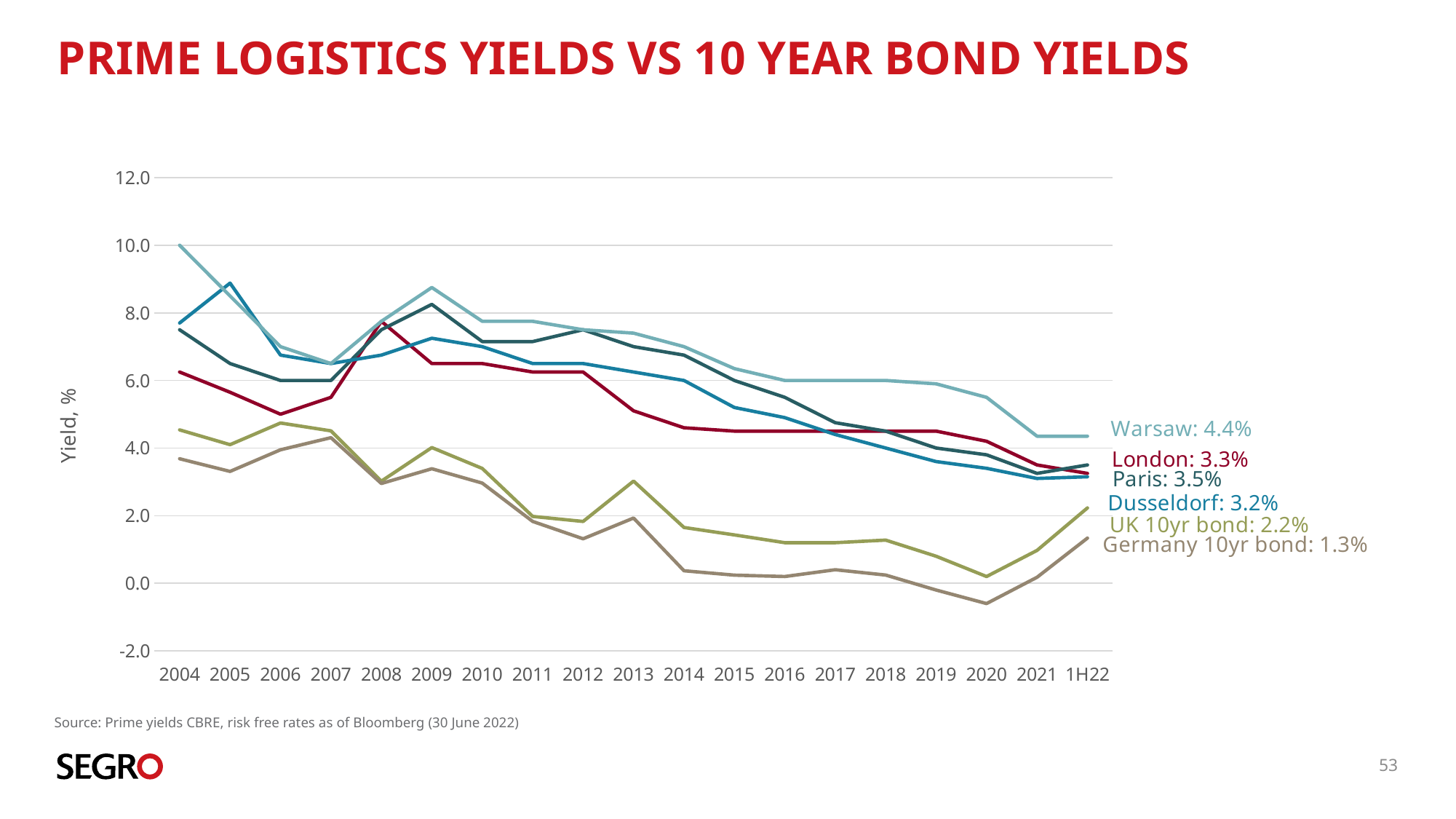
Which series has the highest yield at 1H22? Warsaw What is the Dusseldorf yield at 1H22? 3.2% At 1H22, which is higher: the Paris yield or the London yield? Paris What is the difference between the Warsaw yield and the Germany 10yr bond yield at 1H22? 3.1 percentage points Does the Warsaw yield generally rise or fall from 2004 to 1H22? Fall What is the Germany 10yr bond yield at 1H22? 1.3% How many series are plotted on the chart? 6 How many time points are shown on the x axis? 19 What is the Warsaw prime logistics yield at 1H22? 4.4% Is the Germany 10yr bond yield in 2020 greater or less than 0.0? less Which series has the lowest yield at 1H22? Germany 10yr bond What kind of chart is shown on the slide? Line chart